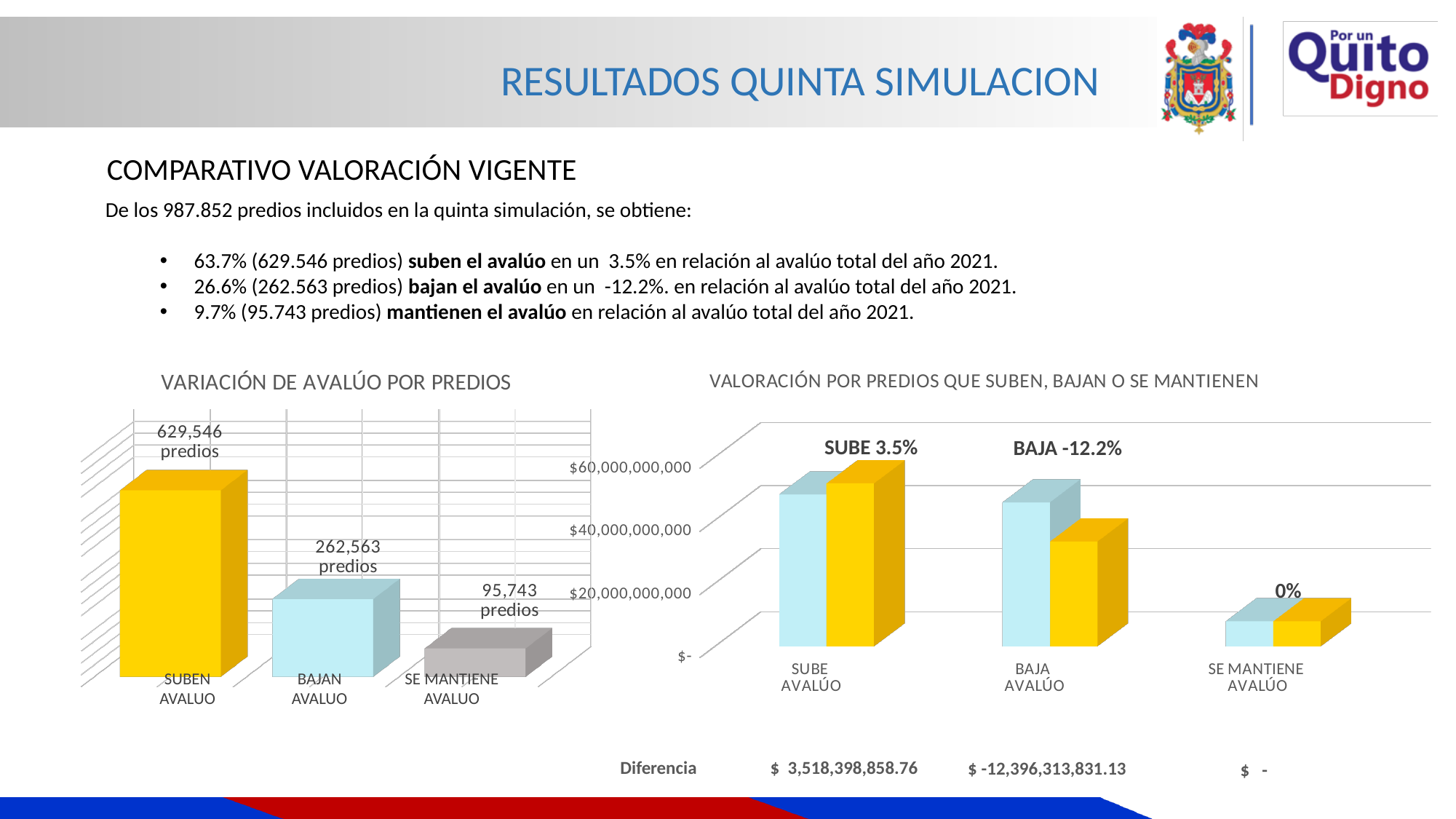
In the chart titled VARIACIÓN DE AVALÚO POR PREDIOS, what value is shown for SE MANTIENE AVALUO? 95,743 predios In the chart titled VALORACIÓN POR PREDIOS QUE SUBEN, BAJAN O SE MANTIENEN, is the yellow bar for SUBE AVALÚO greater or less than $40,000,000,000? greater In the chart titled VALORACIÓN POR PREDIOS QUE SUBEN, BAJAN O SE MANTIENEN, what percentage label is shown above the BAJA AVALÚO bars? BAJA -12.2% In the chart titled VARIACIÓN DE AVALÚO POR PREDIOS, which category has the highest value? SUBEN AVALUO In the chart titled VARIACIÓN DE AVALÚO POR PREDIOS, what value is shown for BAJAN AVALUO? 262,563 predios In the chart titled VARIACIÓN DE AVALÚO POR PREDIOS, how many categories are shown? 3 In the chart titled VARIACIÓN DE AVALÚO POR PREDIOS, what value is shown for SUBEN AVALUO? 629,546 predios What kind of chart is the one titled VARIACIÓN DE AVALÚO POR PREDIOS? Bar chart In the chart titled VALORACIÓN POR PREDIOS QUE SUBEN, BAJAN O SE MANTIENEN, are the values for SE MANTIENE AVALÚO greater or less than $20,000,000,000? less In the chart titled VALORACIÓN POR PREDIOS QUE SUBEN, BAJAN O SE MANTIENEN, what percentage label is shown above the SUBE AVALÚO bars? SUBE 3.5% In the chart titled VARIACIÓN DE AVALÚO POR PREDIOS, what is the difference between the SUBEN AVALUO and BAJAN AVALUO values? 366,983 predios In the chart titled VARIACIÓN DE AVALÚO POR PREDIOS, which category has the lowest value? SE MANTIENE AVALUO